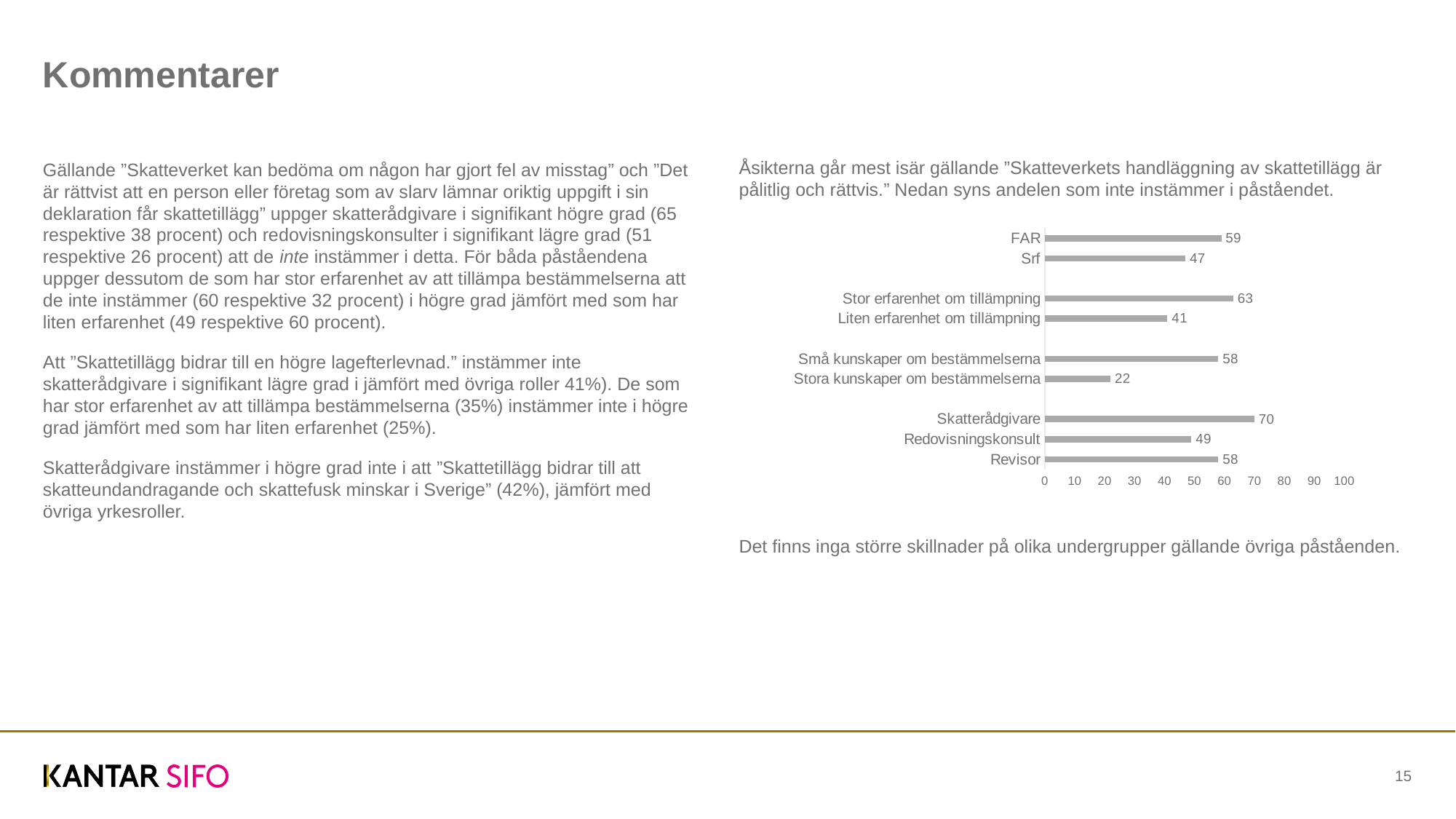
What is the difference between the values for Stor erfarenhet om tillämpning and Liten erfarenhet om tillämpning? 22 Is the value for Revisor greater or less than 50? greater Which has a larger value, FAR or Srf? FAR What is the value for Liten erfarenhet om tillämpning in the bar chart? 41 What is the value for Skatterådgivare in the bar chart? 70 Which category has the highest value in the bar chart? Skatterådgivare What is the difference between the values for Skatterådgivare and Redovisningskonsult? 21 What kind of chart is shown on the slide? Bar chart What is the value for FAR in the bar chart? 59 How many categories are shown in the bar chart? 9 Which category has the lowest value in the bar chart? Stora kunskaper om bestämmelserna What is the value for Stora kunskaper om bestämmelserna in the bar chart? 22